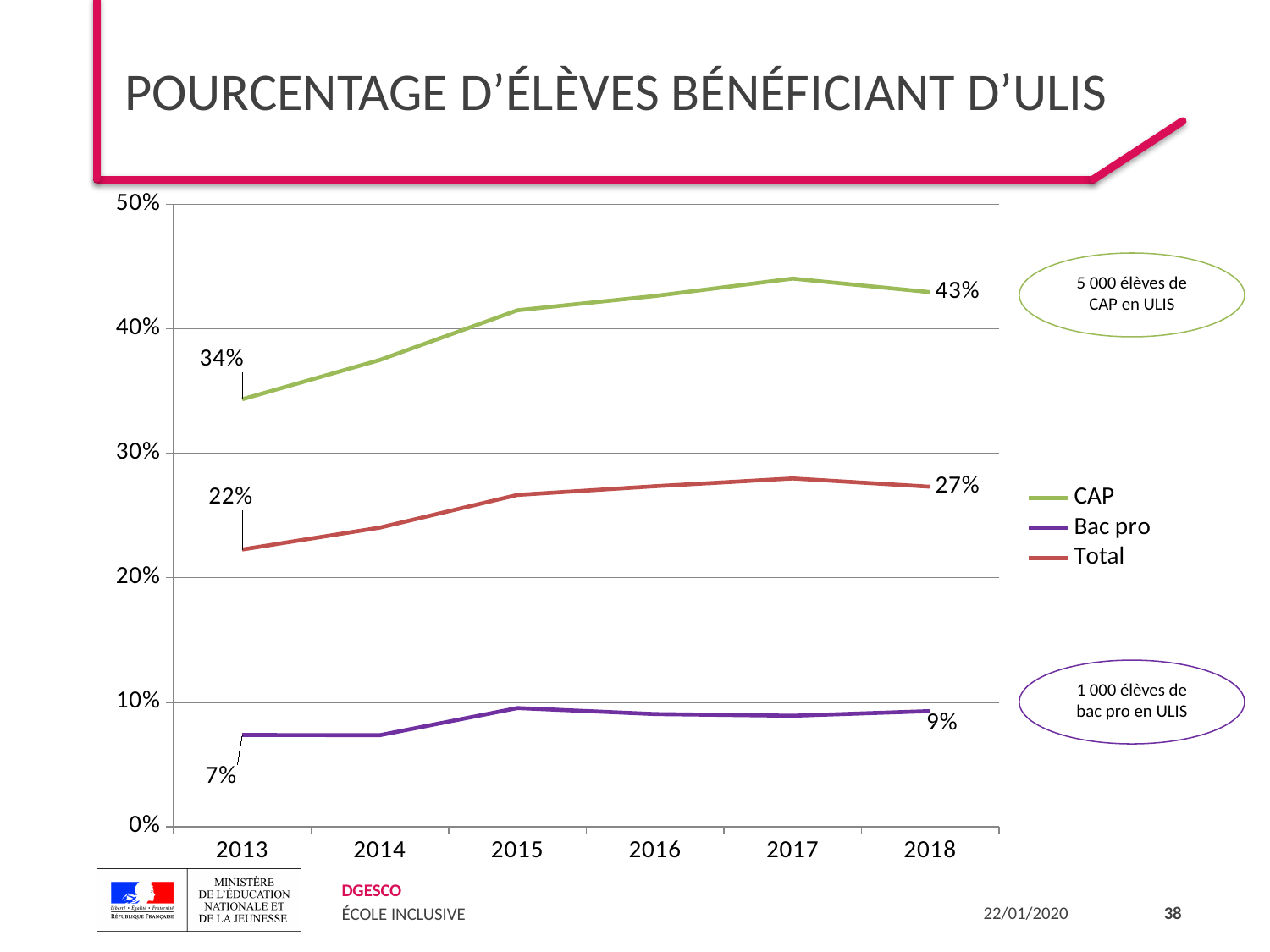
How many years are shown on the x axis? 6 Which series has the lowest value in 2013? Bac pro What is the value for Total in 2013? 22% By how many percentage points did the CAP value change between 2013 and 2018? 9 What is the value for Bac pro in 2018? 9% What is the value for CAP in 2013? 34% What type of chart is shown on the slide? line chart Which series has the highest value in 2018? CAP By how many percentage points did the Total value change between 2013 and 2018? 5 Is the value for CAP in 2017 greater or less than 40%? greater What is the value for CAP in 2018? 43% How many series does the legend list? 3